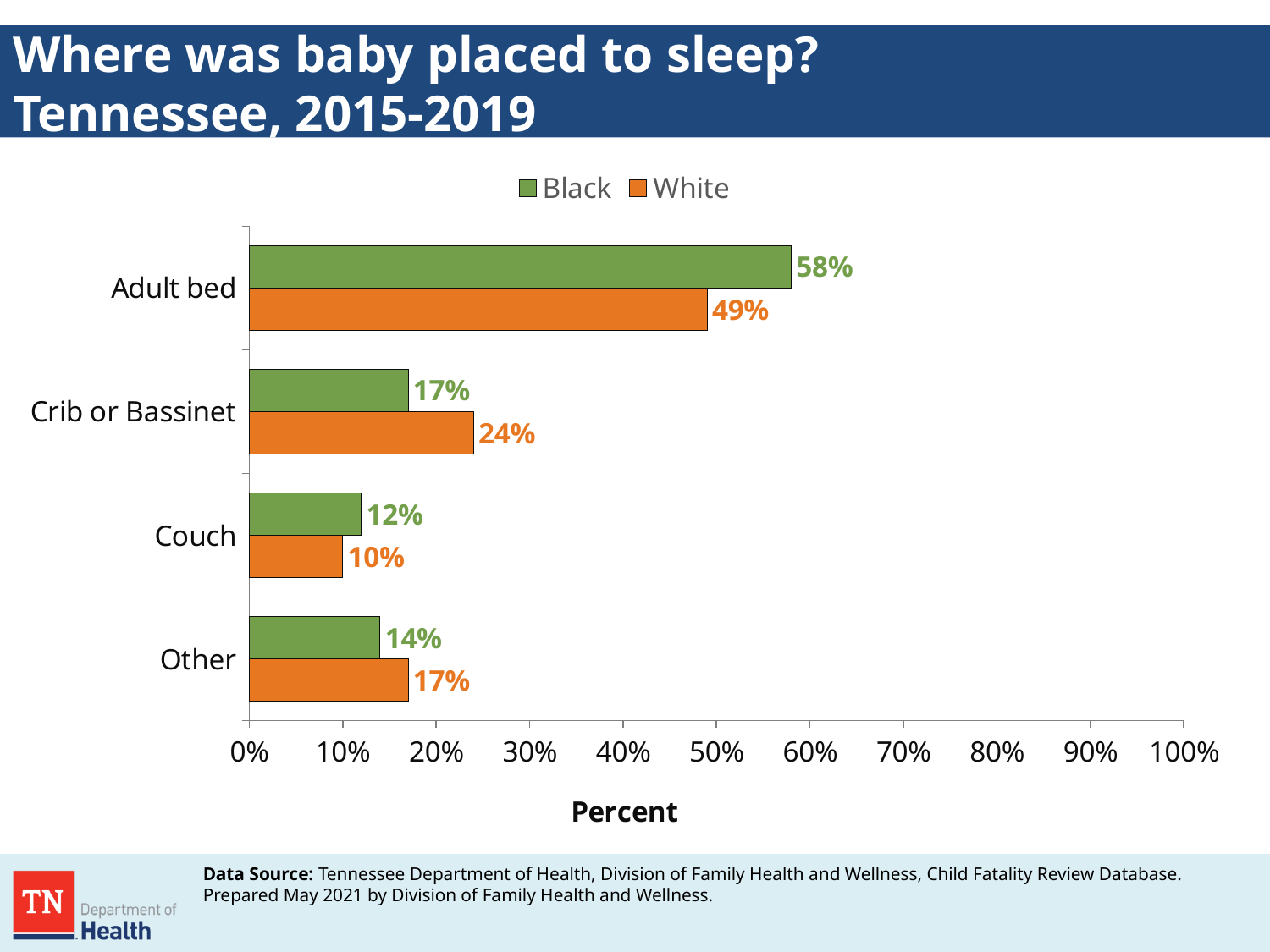
Which sleep location has the lowest value for the White series? Couch How many sleep location categories are shown on the chart? 4 What type of chart is shown on the slide? Bar chart Which sleep location has the highest value for the Black series? Adult bed What percentage of White infants were placed to sleep in a crib or bassinet? 24% How many series does the legend list? 2 What percentage of Black infants were placed to sleep in an adult bed? 58% What is the difference between the Black and White values for Adult bed? 9% Is the value for Black infants in the Adult bed category greater or less than 50%? greater What is the difference between the White and Black values for Crib or Bassinet? 7% For the Other category, which series has the larger value, Black or White? White What is the value for White infants in the Couch category? 10%